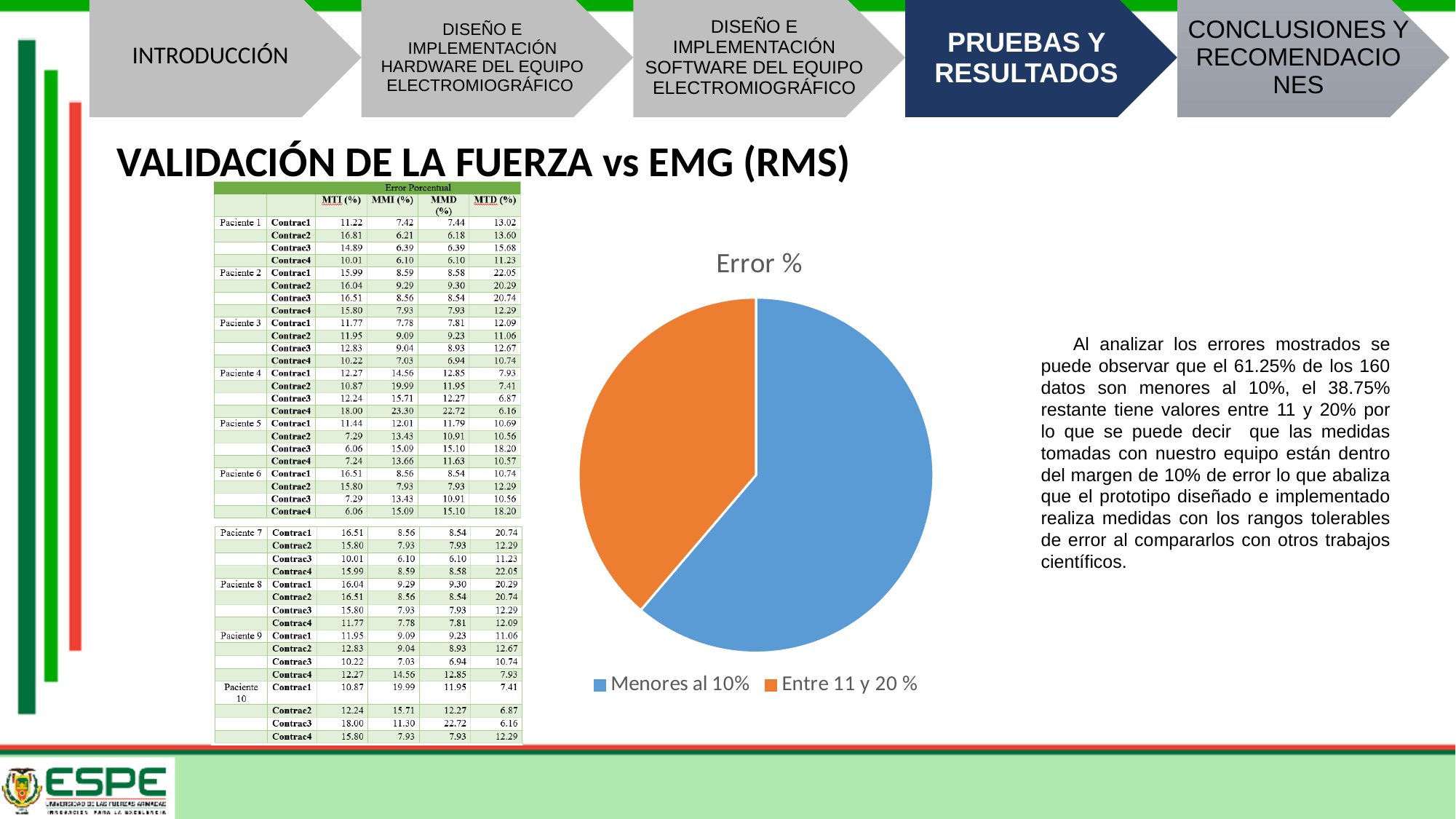
What kind of chart is the 'Error %' chart? pie chart How many entries does the legend of the 'Error %' chart list? 2 In the 'Error %' pie chart, is the 'Entre 11 y 20 %' slice more or less than half of the pie? less Which slice is the smallest in the 'Error %' pie chart? Entre 11 y 20 % What is the title of the pie chart on the slide? Error % In the 'Error %' pie chart, is the 'Menores al 10%' slice more or less than half of the pie? more What colour is the 'Menores al 10%' slice in the 'Error %' pie chart? blue How many slices does the 'Error %' pie chart have? 2 Which slice is the largest in the 'Error %' pie chart? Menores al 10% In the 'Error %' pie chart, which is larger: 'Menores al 10%' or 'Entre 11 y 20 %'? Menores al 10%